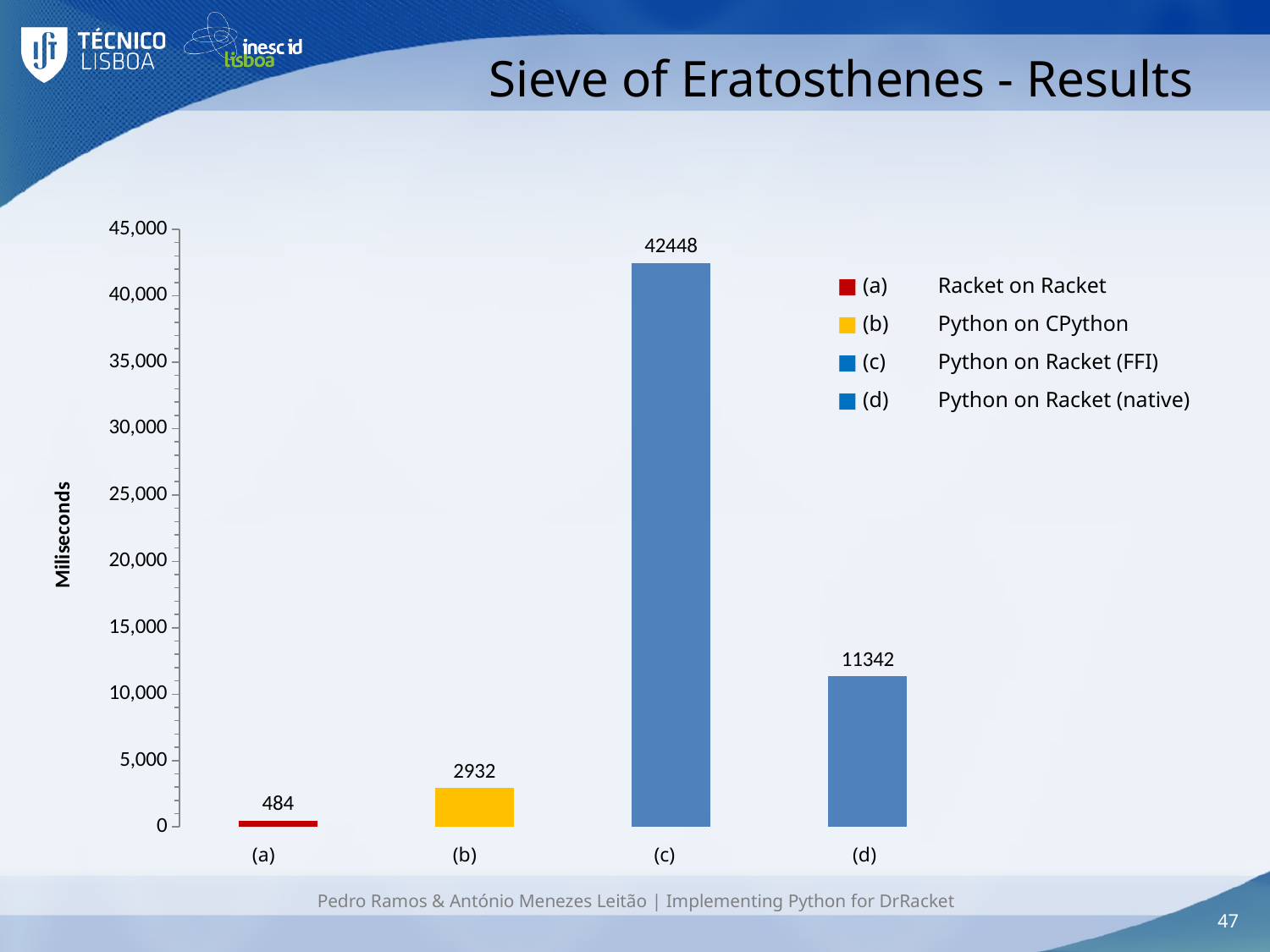
What is the value for (d) Python on Racket (native)? 11342 What is the label of the y axis? Miliseconds What is the difference between the values for (b) and (a)? 2448 How many categories are shown on the x axis? 4 Which category has the lowest value? (a) What is the value for (b) Python on CPython? 2932 What is the value for (a) Racket on Racket? 484 Which is larger, the value for (b) or the value for (d)? (d) What is the difference between the values for (c) and (d)? 31106 What is the value for (c) Python on Racket (FFI)? 42448 What kind of chart is shown on the slide? bar chart Which category has the highest value? (c)